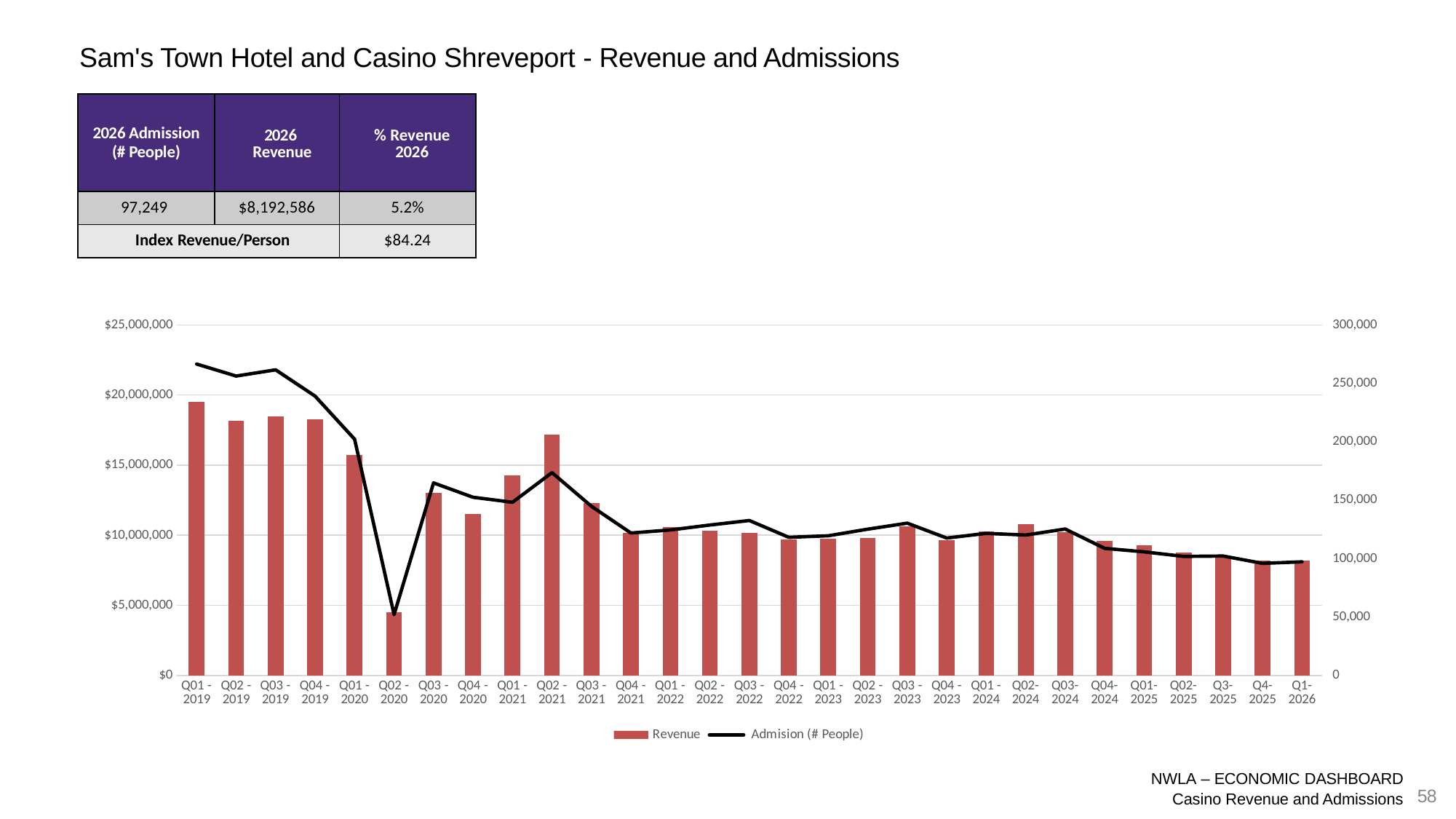
Is the Revenue for Q02 - 2021 greater or less than $15,000,000? greater Does the Revenue generally rise or fall from Q01 - 2024 to Q1 - 2026? fall Which quarter has the lowest Revenue bar? Q02 - 2020 Is the Admision (# People) value for Q02 - 2020 greater or less than 100,000? less Is the Revenue for Q02 - 2020 greater or less than $5,000,000? less How many quarters are plotted along the x axis of the chart? 29 What kind of chart is used to show the Revenue series? bar chart What are the two entries shown in the chart legend? Revenue and Admision (# People) How many series does the chart legend list? 2 Which quarter has the highest Revenue bar? Q01 - 2019 Which quarter has the larger Revenue bar, Q01 - 2021 or Q02 - 2021? Q02 - 2021 Which quarter has the lowest point on the Admision (# People) line? Q02 - 2020